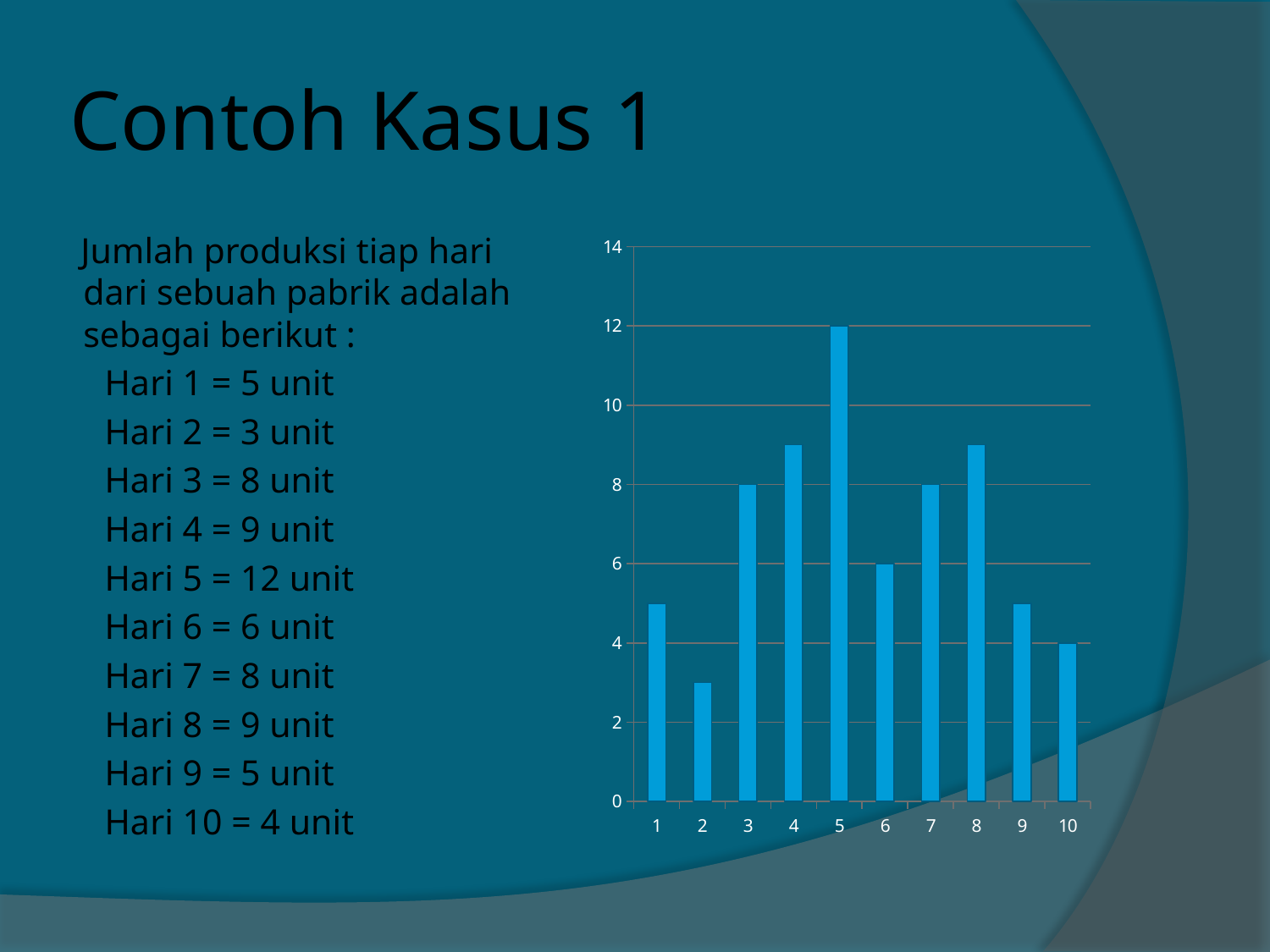
What is the production value for day 10? 4 Is the value for day 1 greater or less than 4? greater Which day has the lowest production in the chart? 2 What is the production value for day 5? 12 Is the value for day 9 greater or less than 8? less How many days (categories) are plotted on the x axis of the chart? 10 What is the production value for day 6? 6 What type of chart is shown on the slide? bar chart Which is larger, the production on day 4 or on day 6? day 4 What is the production value for day 3? 8 What is the difference between the production on day 5 and day 2? 9 Which day has the highest production in the chart? 5